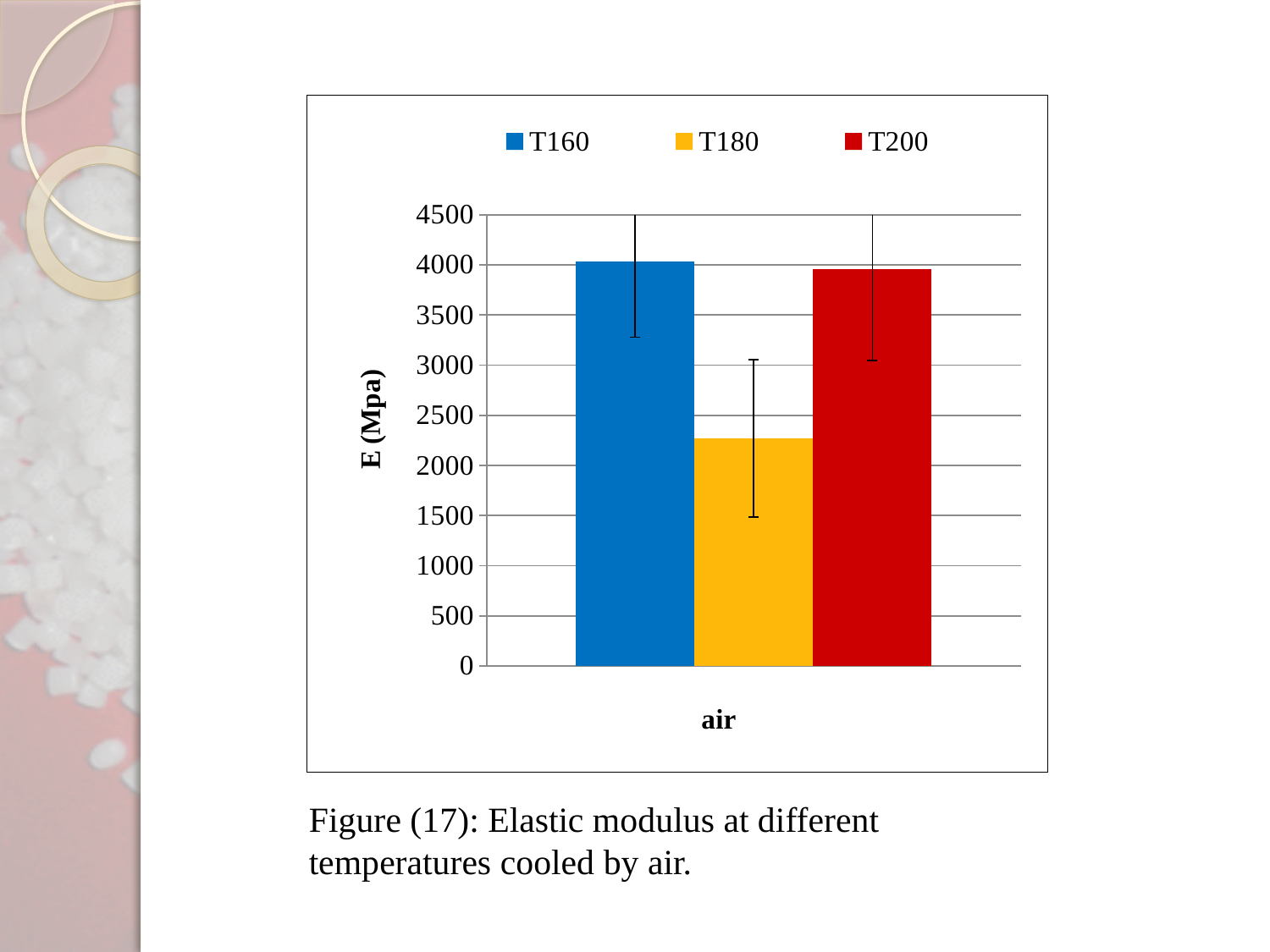
What is the label of the y axis? E (Mpa) How many categories are shown on the x axis? 1 What colour is the bar for the T180 series? yellow Which series has the lowest value for air? T180 How many series does the legend list? 3 Is the value for T180 greater or less than 2500? less Is the value for T160 greater or less than 3500? greater Is the value for T180 greater or less than 2000? greater Which is larger for air, the value for T160 or the value for T180? T160 What kind of chart is shown on the slide? bar chart Which is larger for air, the value for T180 or the value for T200? T200